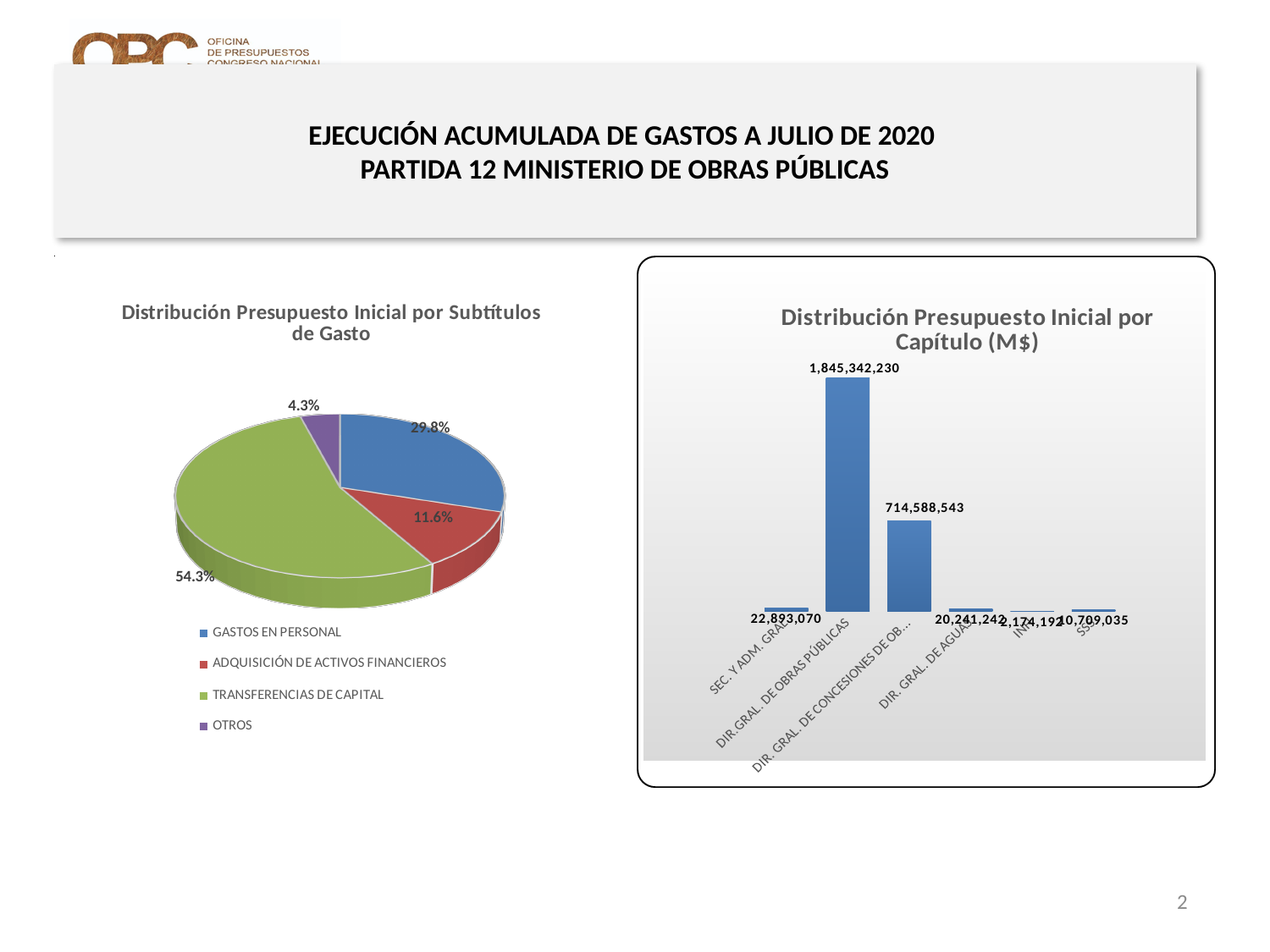
In the chart 'Distribución Presupuesto Inicial por Capítulo (M$)', what is the value for SEC. Y ADM. GRAL.? 22,893,070 What kind of chart is 'Distribución Presupuesto Inicial por Subtítulos de Gasto'? Pie chart In the pie chart 'Distribución Presupuesto Inicial por Subtítulos de Gasto', what is the difference in percentage points between TRANSFERENCIAS DE CAPITAL and GASTOS EN PERSONAL? 24.5 percentage points In the pie chart 'Distribución Presupuesto Inicial por Subtítulos de Gasto', which category has the smallest slice? OTROS In the pie chart 'Distribución Presupuesto Inicial por Subtítulos de Gasto', which category has the largest slice? TRANSFERENCIAS DE CAPITAL In the pie chart 'Distribución Presupuesto Inicial por Subtítulos de Gasto', what is the value for GASTOS EN PERSONAL? 29.8% In the chart 'Distribución Presupuesto Inicial por Capítulo (M$)', which category has the highest value? DIR.GRAL. DE OBRAS PÚBLICAS In the pie chart 'Distribución Presupuesto Inicial por Subtítulos de Gasto', how many categories are shown? 4 In the pie chart 'Distribución Presupuesto Inicial por Subtítulos de Gasto', what share does TRANSFERENCIAS DE CAPITAL have? 54.3% What kind of chart is 'Distribución Presupuesto Inicial por Capítulo (M$)'? Bar chart In the chart 'Distribución Presupuesto Inicial por Capítulo (M$)', what is the value for DIR.GRAL. DE OBRAS PÚBLICAS? 1,845,342,230 In the chart 'Distribución Presupuesto Inicial por Capítulo (M$)', which is larger: SEC. Y ADM. GRAL. or DIR. GRAL. DE AGUAS? SEC. Y ADM. GRAL.